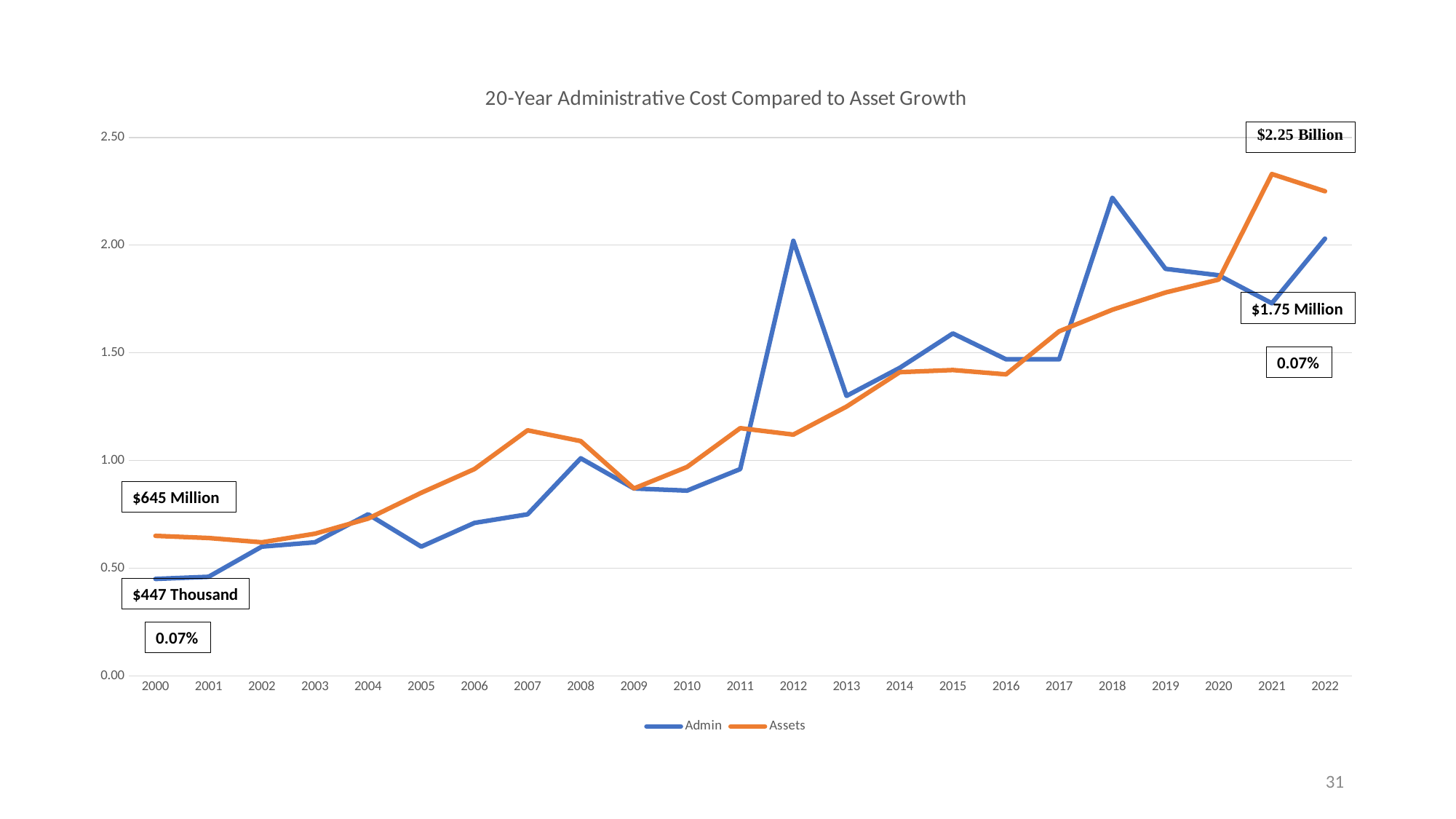
Is the value for Admin in 2000 greater or less than 0.50? less What type of chart is shown on the slide? line chart Is the value for Admin in 2013 greater or less than 1.50? less Is the value for Admin in 2018 greater or less than 2.00? greater How many series does the legend list? 2 What is the title of the chart? 20-Year Administrative Cost Compared to Asset Growth In which year does the Admin series reach its highest value? 2018 How many years are plotted along the x axis? 23 In 2007, which series has the larger value, Admin or Assets? Assets In 2012, which series has the larger value, Admin or Assets? Admin In which year does the Assets series reach its highest value? 2021